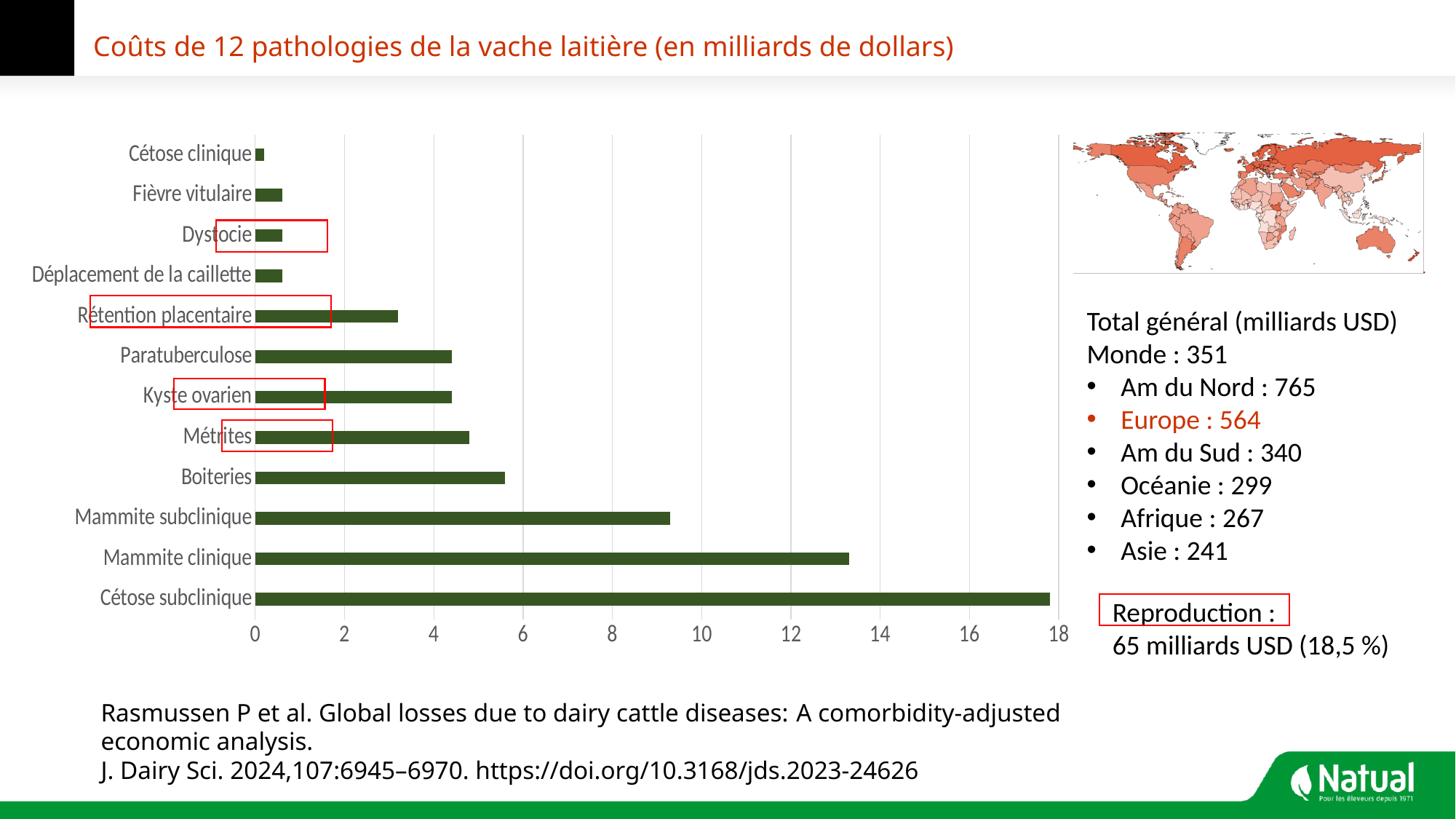
Which has a larger cost, Boiteries or Rétention placentaire? Boiteries How many pathologies (categories) are plotted in the bar chart? 12 Is the value for Mammite clinique greater or less than 12? greater Which has a larger cost, Mammite clinique or Mammite subclinique? Mammite clinique Is the value for Fièvre vitulaire greater or less than 2? less Is the value for Rétention placentaire greater or less than 2? greater Which pathology has the lowest cost in the bar chart? Cétose clinique Which pathology has the highest cost in the bar chart? Cétose subclinique What kind of chart is shown on the slide? bar chart What is the title of the chart on the slide? Coûts de 12 pathologies de la vache laitière (en milliards de dollars)